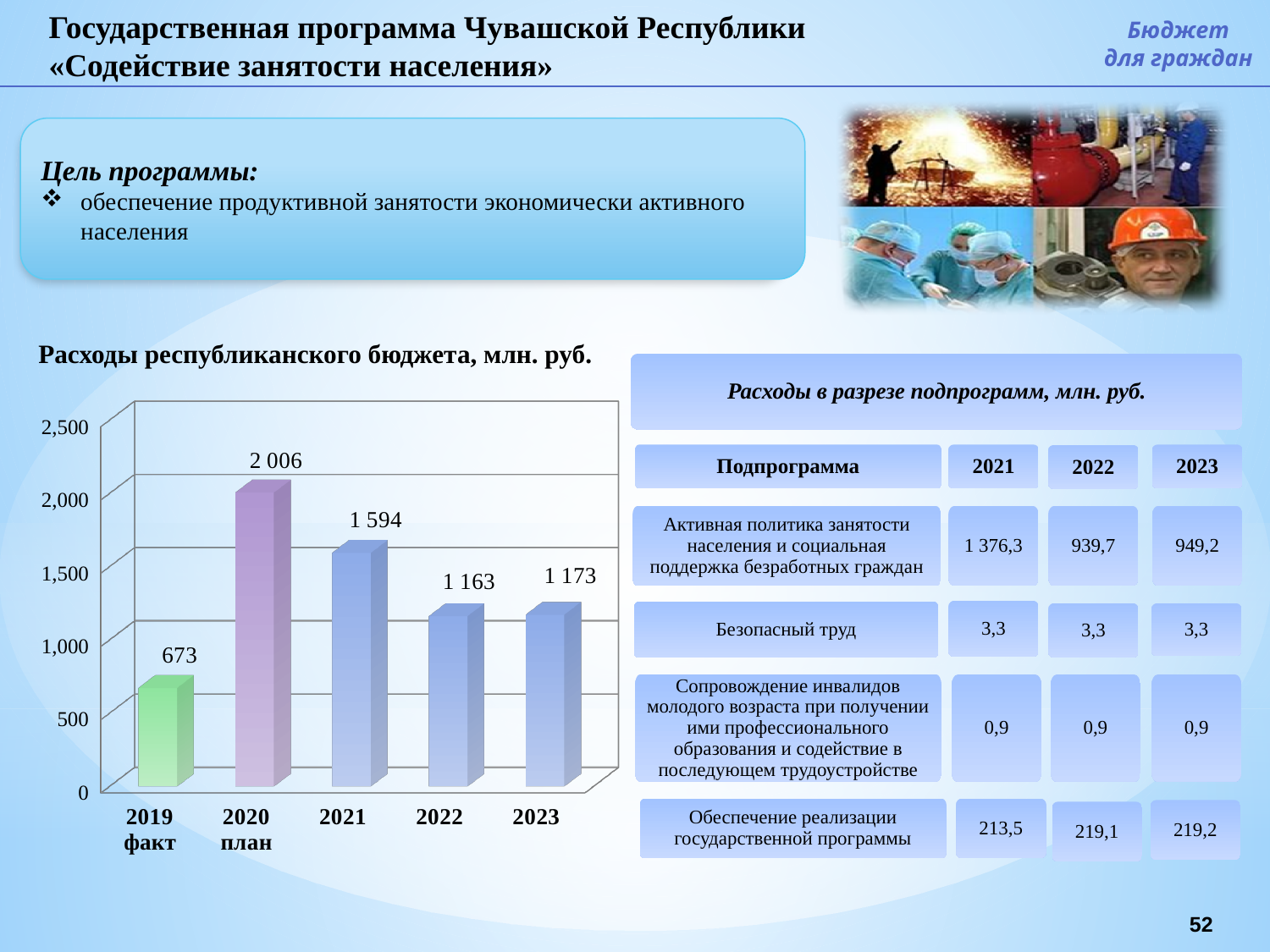
What is the difference between the values for 2021 and 2022? 431 Which category has the highest value in the chart? 2020 план What is the difference between the values for '2020 план' and '2019 факт'? 1 333 How many categories are shown on the x axis of the chart? 5 Is the value for 2022 greater or less than 1,000? greater Which category has the lowest value in the chart? 2019 факт What is the title of the chart on the slide? Расходы республиканского бюджета, млн. руб. What is the value for '2019 факт' in the chart? 673 What kind of chart is shown on the slide? bar chart Which is larger, the value for 2021 or the value for 2023? 2021 What is the value for 2021 in the chart 'Расходы республиканского бюджета, млн. руб.'? 1 594 What is the value for 2023 in the chart? 1 173